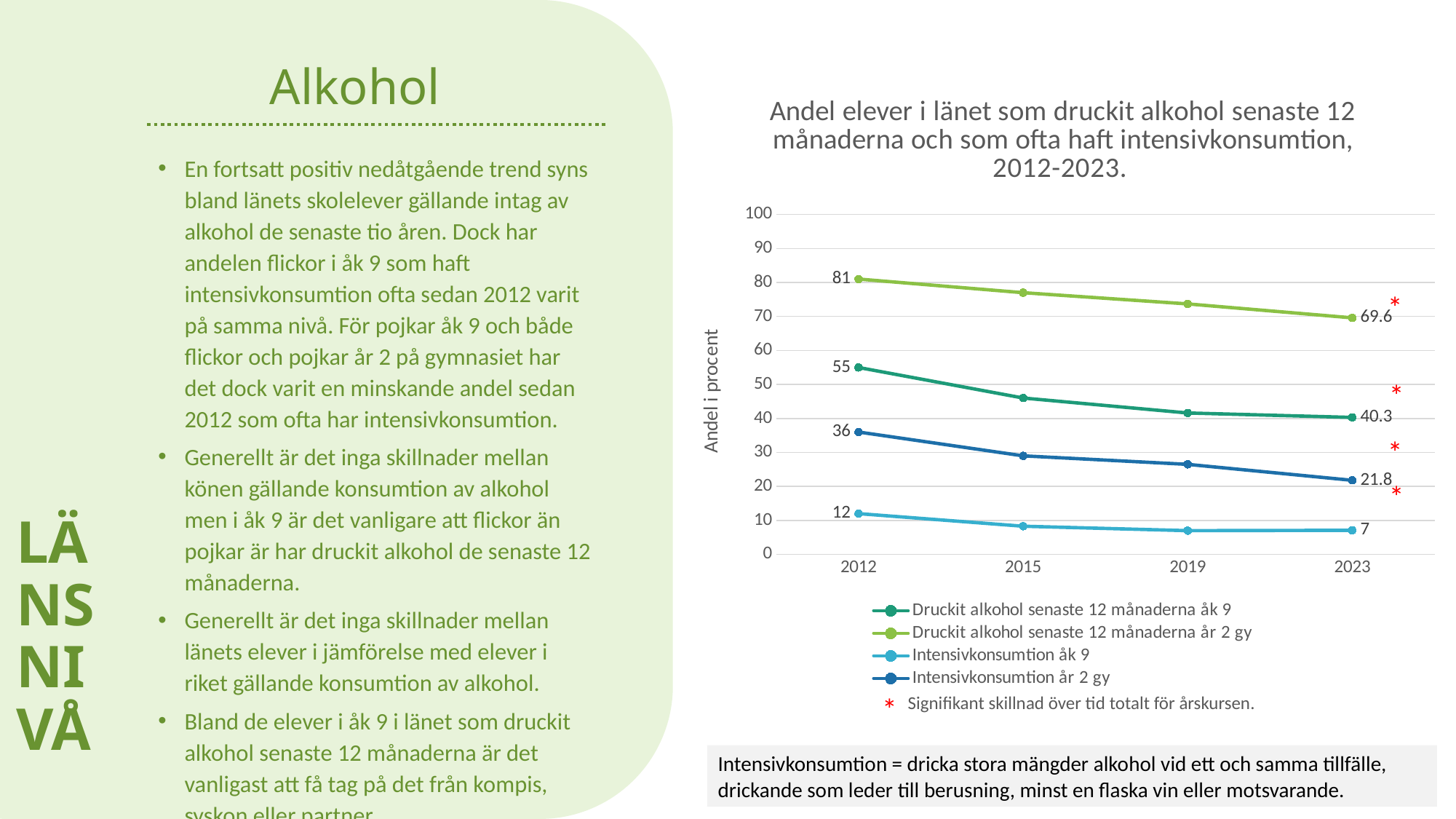
Is the value for 'Druckit alkohol senaste 12 månaderna åk 9' in 2015 greater or less than 40? greater What is the value for 'Druckit alkohol senaste 12 månaderna år 2 gy' in 2023? 69.6 Do the values for 'Intensivkonsumtion år 2 gy' rise or fall from 2012 to 2023? fall Which series has the highest value in 2023? Druckit alkohol senaste 12 månaderna år 2 gy What is the value for 'Intensivkonsumtion år 2 gy' in 2012? 36 What is the value for 'Intensivkonsumtion åk 9' in 2023? 7 How many years are plotted on the x axis? 4 What is the value for 'Druckit alkohol senaste 12 månaderna år 2 gy' in 2012? 81 By how much did 'Druckit alkohol senaste 12 månaderna åk 9' fall from 2012 to 2023? 14.7 What type of chart is shown on the slide? line chart How many series does the legend list? 4 What is the value for 'Druckit alkohol senaste 12 månaderna åk 9' in 2023? 40.3